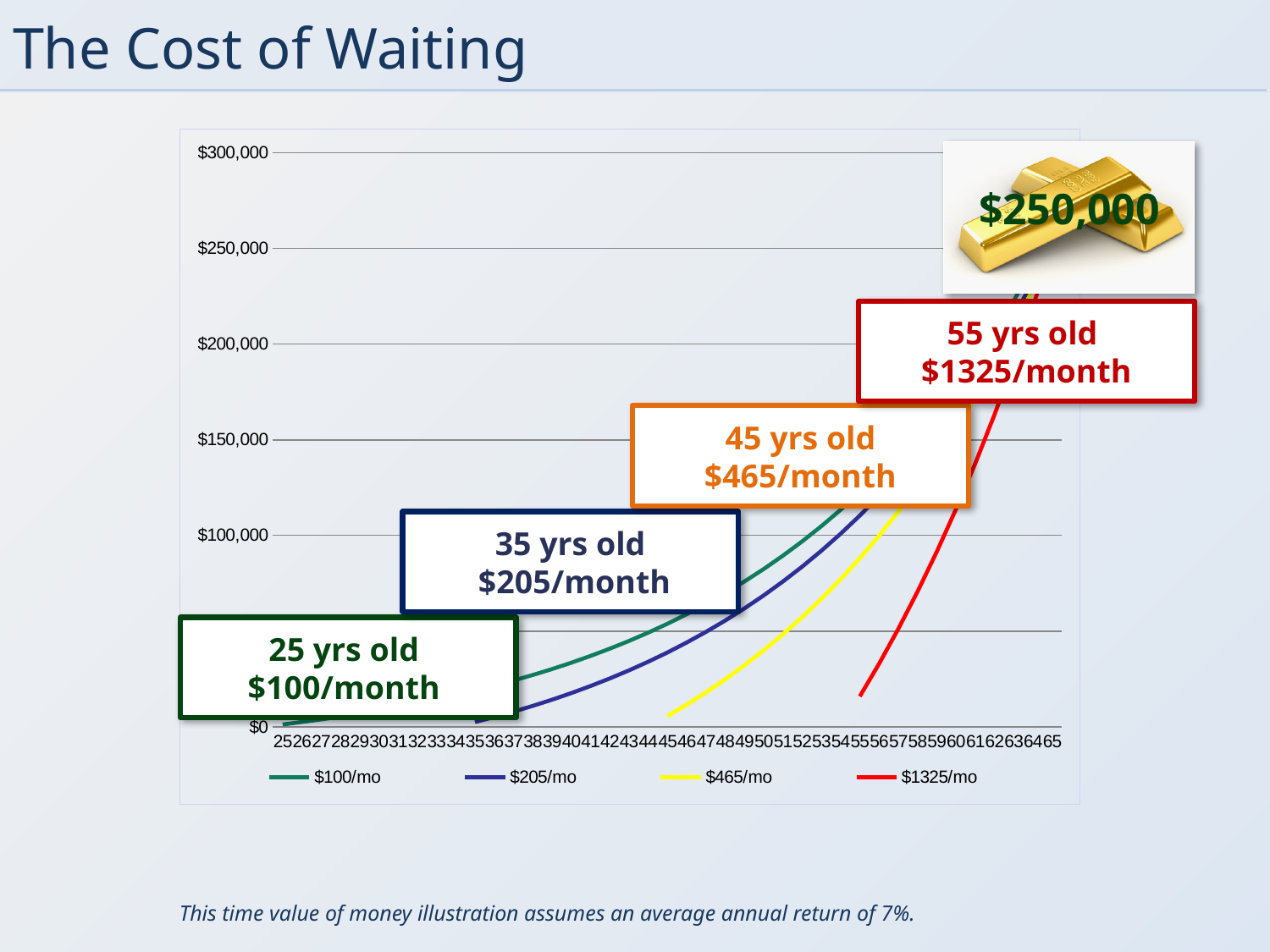
What is the highest value labeled on the y axis? $300,000 Do the lines rise or fall as age increases along the x axis? rise Which series begins at the earliest age on the x axis? $100/mo What kind of chart is shown on the slide? line chart What are the four series listed in the legend? $100/mo, $205/mo, $465/mo, $1325/mo Is the value for the $465/mo series at age 50 greater or less than $100,000? less At age 50, which series has the higher value: $100/mo or $465/mo? $100/mo How many series does the legend list? 4 Is the value for the $100/mo series at age 45 greater or less than $100,000? less What value do all four lines reach at age 65, as labeled on the chart? $250,000